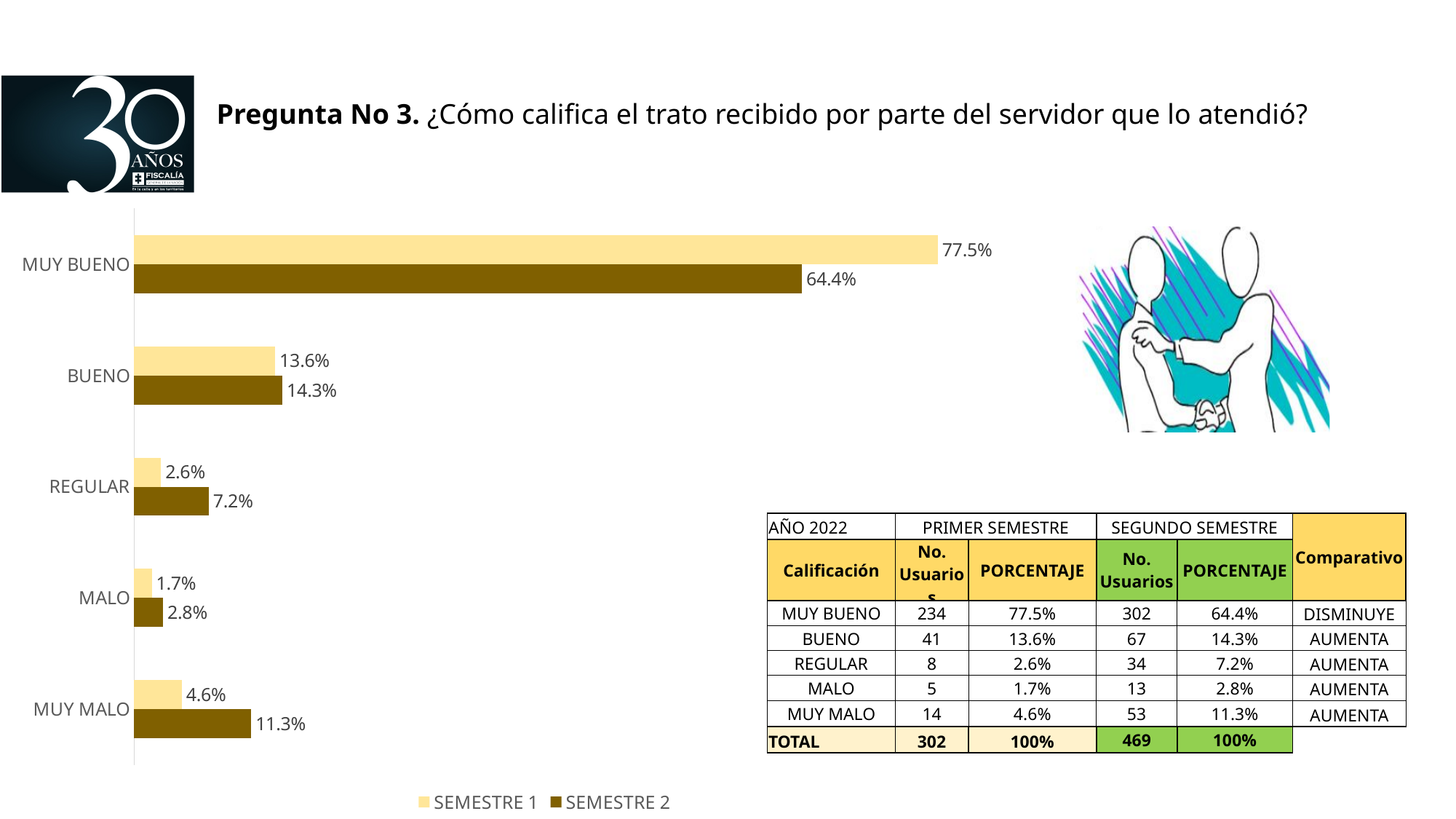
Which is larger for BUENO: the SEMESTRE 1 value or the SEMESTRE 2 value? SEMESTRE 2 What is the value for MUY MALO in the SEMESTRE 2 series? 11.3% Which category has the lowest value in the SEMESTRE 2 series? MALO What is the difference between the SEMESTRE 1 and SEMESTRE 2 values for MUY BUENO? 13.1% What kind of chart is shown on the slide? Bar chart What is the difference between the SEMESTRE 2 and SEMESTRE 1 values for MUY MALO? 6.7% What is the value for REGULAR in the SEMESTRE 2 series? 7.2% How many series does the legend list? 2 Which category has the highest value in the SEMESTRE 1 series? MUY BUENO What is the value for MUY BUENO in the SEMESTRE 1 series? 77.5% How many categories are shown on the chart? 5 What are the two series names listed in the legend? SEMESTRE 1 and SEMESTRE 2